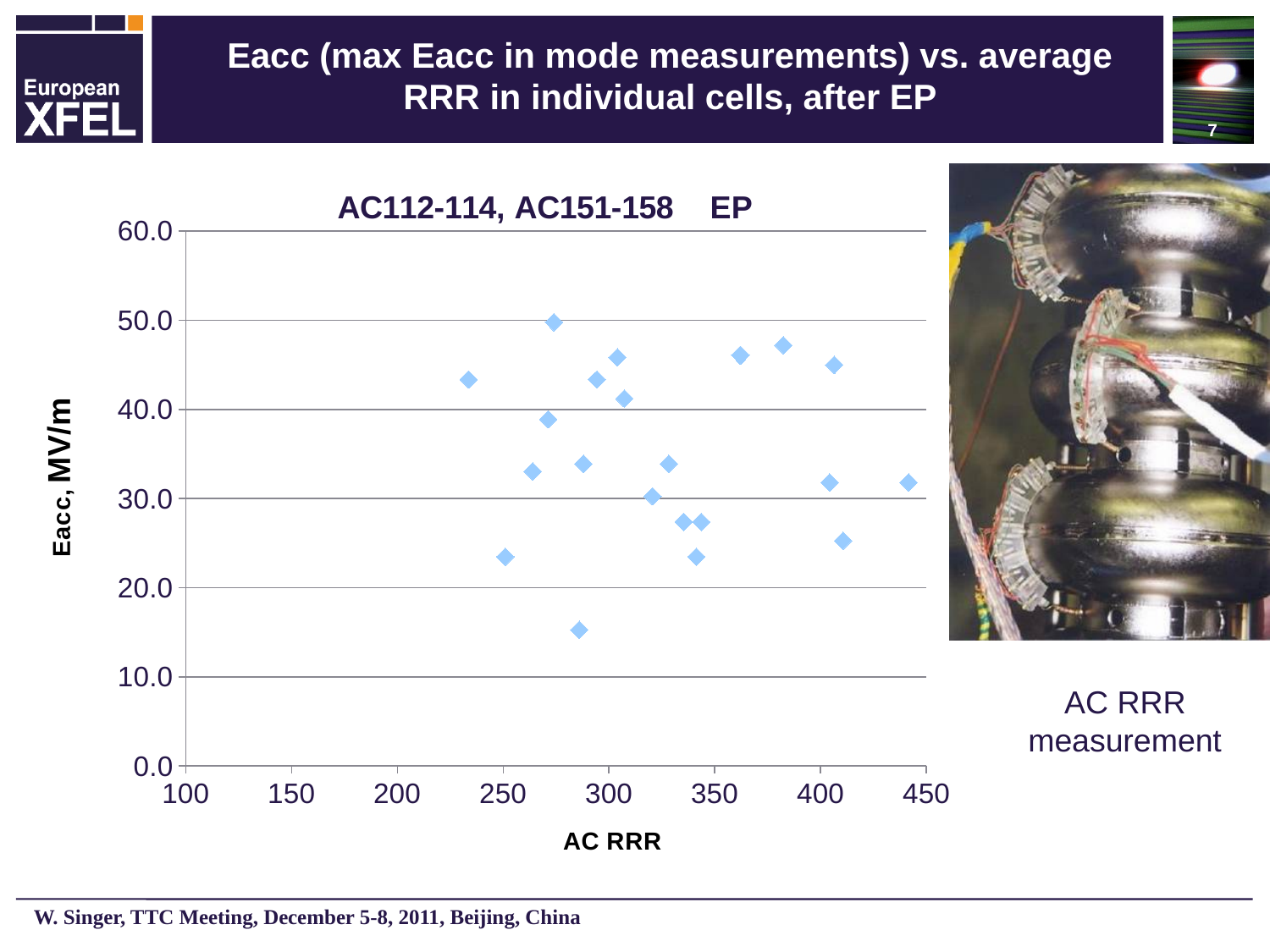
How many data points are plotted in the chart? 21 Is the Eacc value of the point with the smallest AC RRR (near 230) greater or less than 40? greater Is the AC RRR value of the lowest point in the chart greater or less than 300? less Is the Eacc value of the lowest point in the chart greater or less than 20? less What kind of chart is shown on the slide? scatter chart What is the maximum value shown on the x axis of the chart? 450 What is the label of the y axis of the chart? Eacc, MV/m What is the title of the chart? AC112-114, AC151-158 EP Which has the higher Eacc: the point near AC RRR 380 or the point near AC RRR 440? the point near AC RRR 380